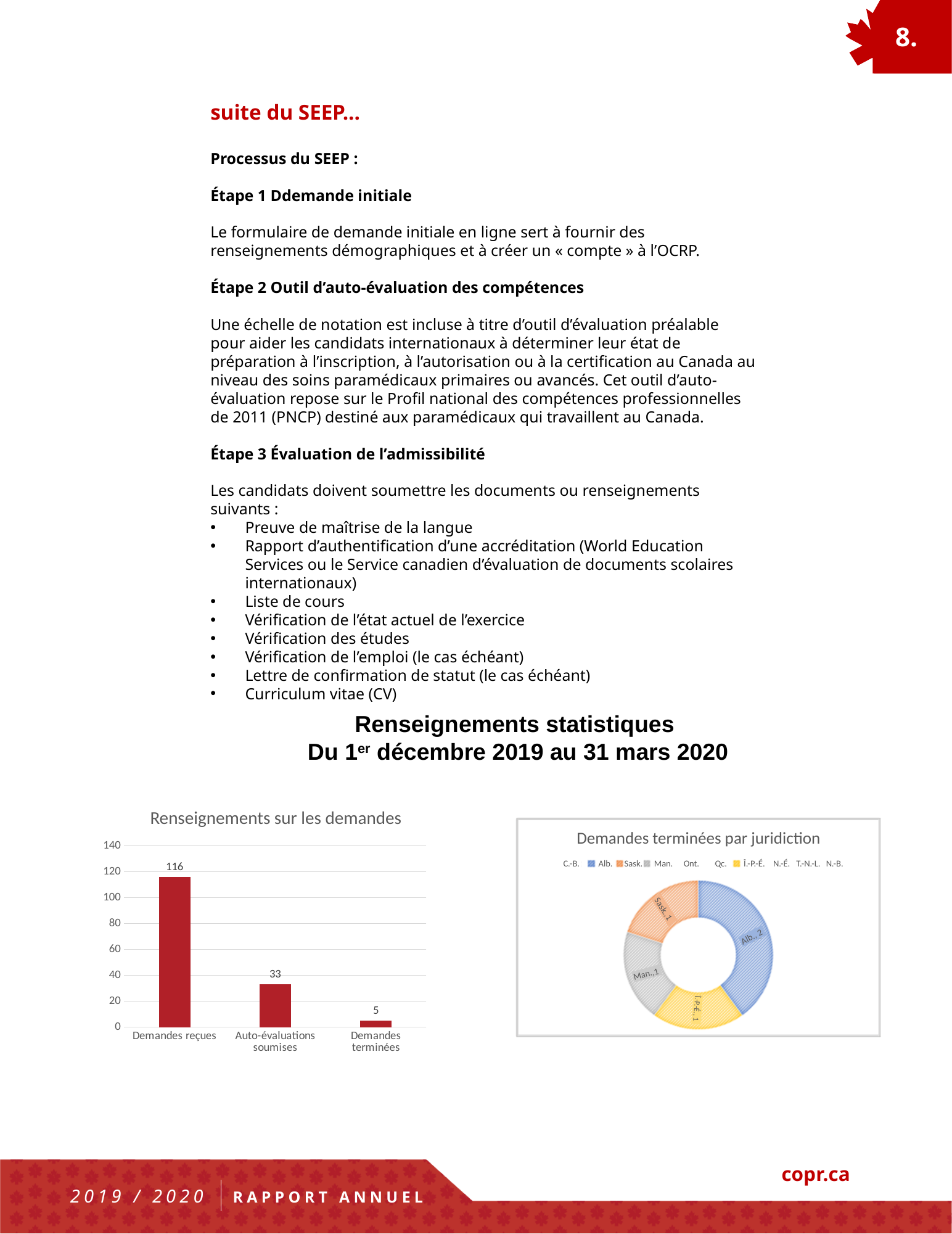
In the chart 'Renseignements sur les demandes', which category has the highest value? Demandes reçues In the chart 'Demandes terminées par juridiction', how many entries does the legend list? 10 In the chart 'Renseignements sur les demandes', what is the difference between Demandes reçues and Auto-évaluations soumises? 83 In the chart 'Renseignements sur les demandes', how many categories are shown on the x axis? 3 What kind of chart is 'Renseignements sur les demandes'? Bar chart In the chart 'Renseignements sur les demandes', what is the value for Auto-évaluations soumises? 33 In the chart 'Renseignements sur les demandes', what is the value for Demandes terminées? 5 In the chart 'Demandes terminées par juridiction', which jurisdiction has the largest slice? Alb. In the chart 'Demandes terminées par juridiction', what is the value for Alb.? 2 In the chart 'Renseignements sur les demandes', what is the value for Demandes reçues? 116 In the chart 'Renseignements sur les demandes', which category has the lowest value? Demandes terminées In the chart 'Renseignements sur les demandes', do the values rise or fall from left to right? Fall